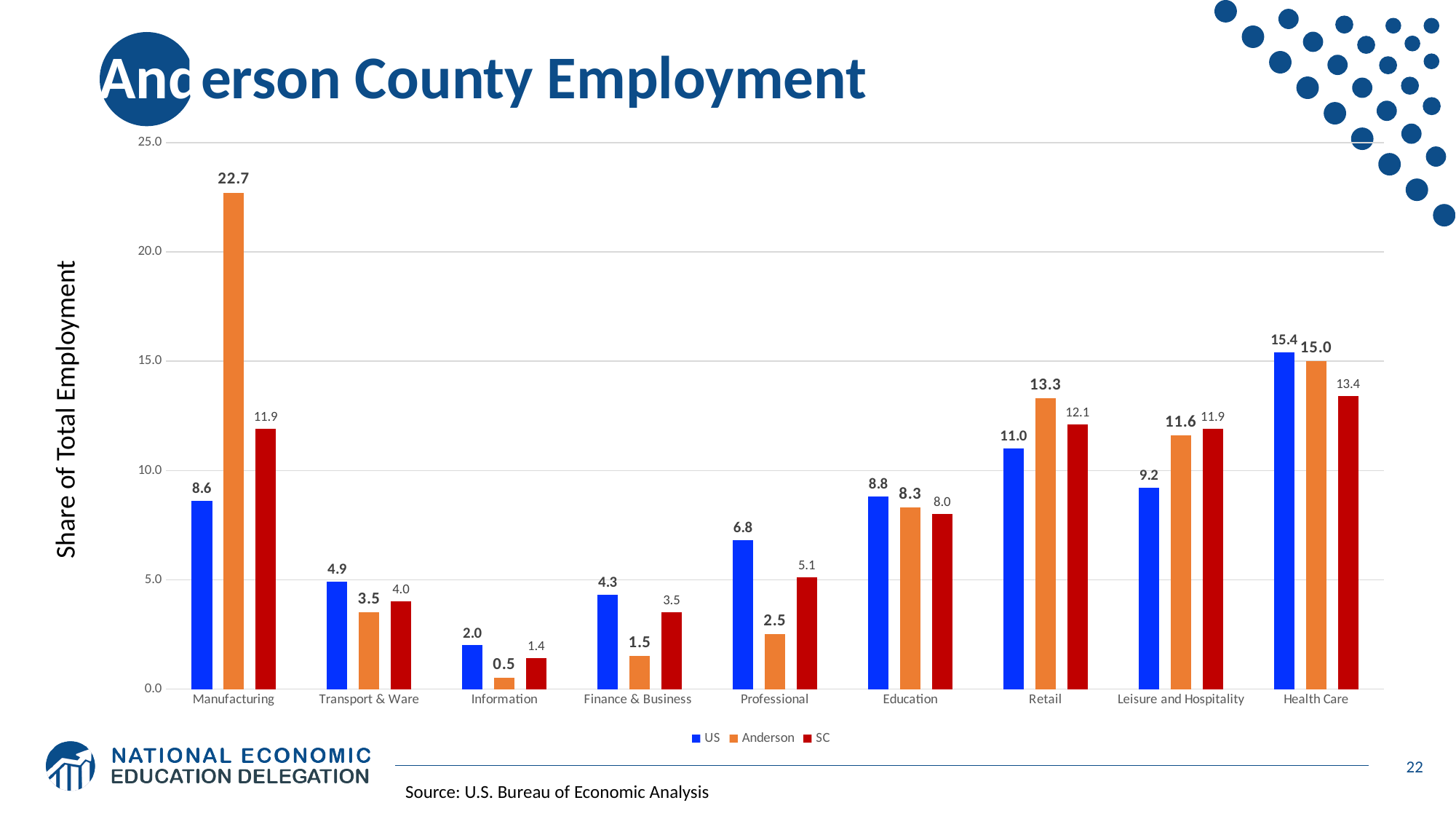
What is the Anderson value for Manufacturing? 22.7 What is the label on the vertical axis? Share of Total Employment How many series does the legend list? 3 How many categories are shown on the x axis? 9 Which is larger for Retail, the US value or the Anderson value? Anderson What is the US value for Leisure and Hospitality? 9.2 Which category has the highest Anderson value? Manufacturing Is the SC value for Health Care greater or less than 15.0? less What is the SC value for Professional? 5.1 What kind of chart is shown on the slide? bar chart What is the difference between the Anderson and SC values for Manufacturing? 10.8 Which category has the lowest US value? Information